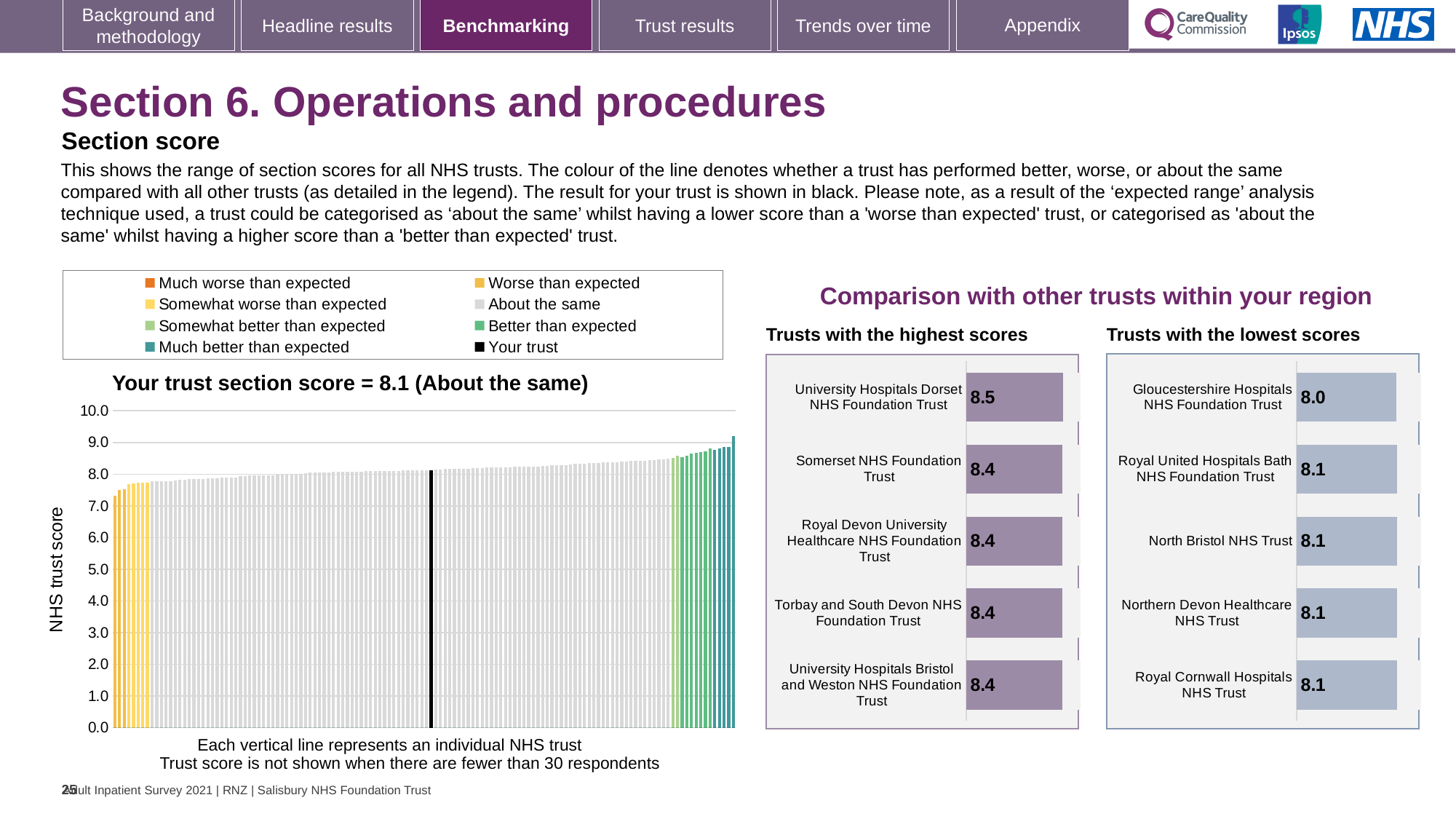
In the 'Your trust section score' chart, do the bars rise or fall from left to right? rise What kind of chart is the 'Your trust section score' chart on the left of the slide? bar chart In the 'Trusts with the lowest scores' chart, what is the score for Gloucestershire Hospitals NHS Foundation Trust? 8.0 How many entries does the legend above the 'Your trust section score' chart list? 8 What is the y-axis label of the 'Your trust section score' chart? NHS trust score In the 'Trusts with the lowest scores' chart, which trust has the lowest score? Gloucestershire Hospitals NHS Foundation Trust In the 'Trusts with the highest scores' chart, what is the score for University Hospitals Dorset NHS Foundation Trust? 8.5 In the 'Your trust section score' chart, is the value of the leftmost (lowest) bar greater or less than 8.0? less In the 'Trusts with the highest scores' chart, what is the difference between the scores of University Hospitals Dorset NHS Foundation Trust and Somerset NHS Foundation Trust? 0.1 In the 'Trusts with the highest scores' chart, how many trusts are shown? 5 In the 'Your trust section score' chart, what is the section score for your trust? 8.1 In the 'Trusts with the highest scores' chart, which trust has the highest score? University Hospitals Dorset NHS Foundation Trust